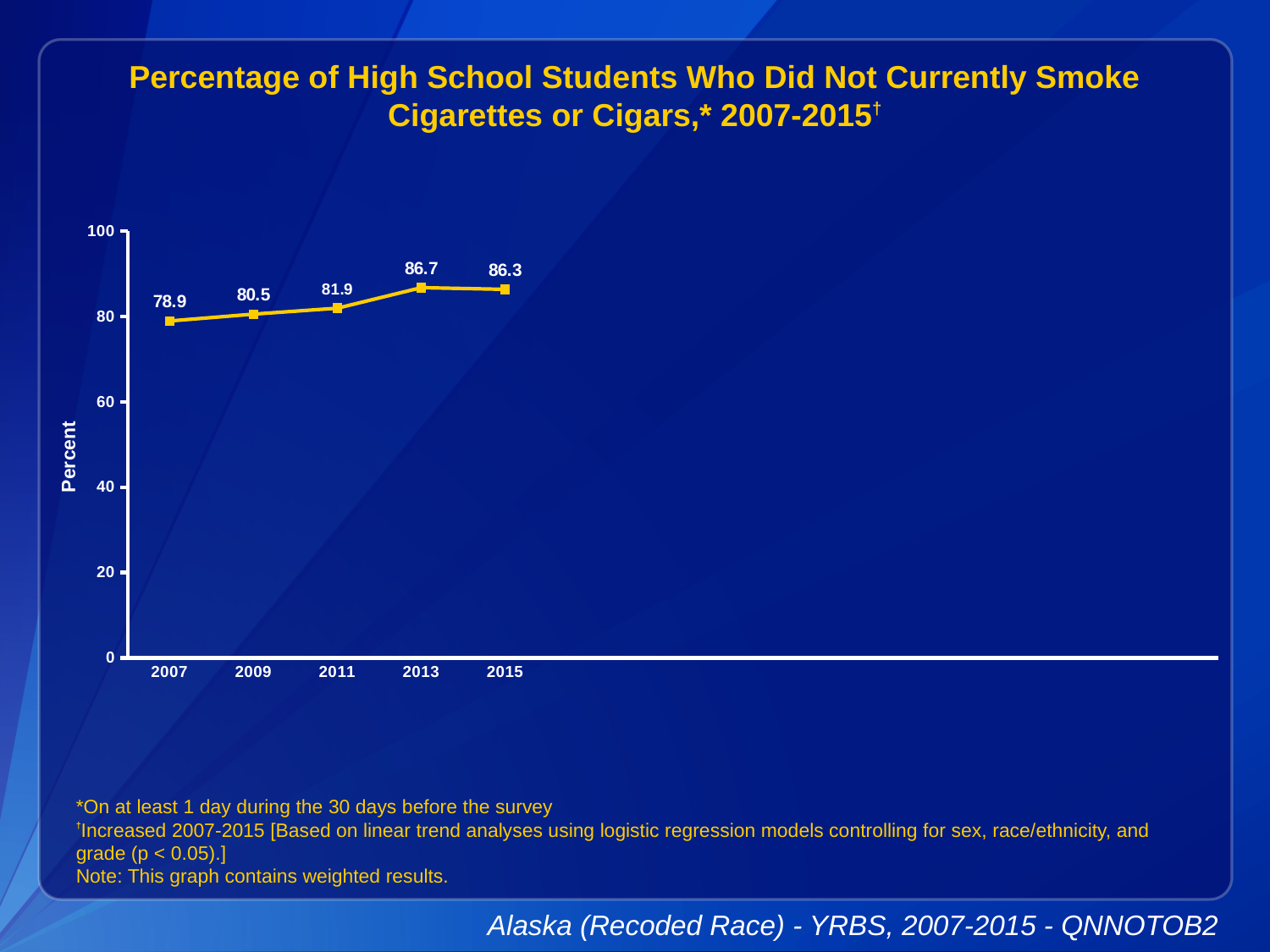
What is the label on the y axis? Percent Which year has the lowest value? 2007 What is the difference between the values for 2013 and 2007? 7.8 Which is larger, the value for 2009 or the value for 2011? 2011 Do the values generally rise or fall from 2007 to 2013? rise What is the value for 2015? 86.3 What is the value for 2011? 81.9 Which year has the highest value? 2013 How many years are plotted on the chart? 5 What kind of chart is shown? line chart Is the value for 2013 greater or less than 80? greater What is the value for 2007? 78.9